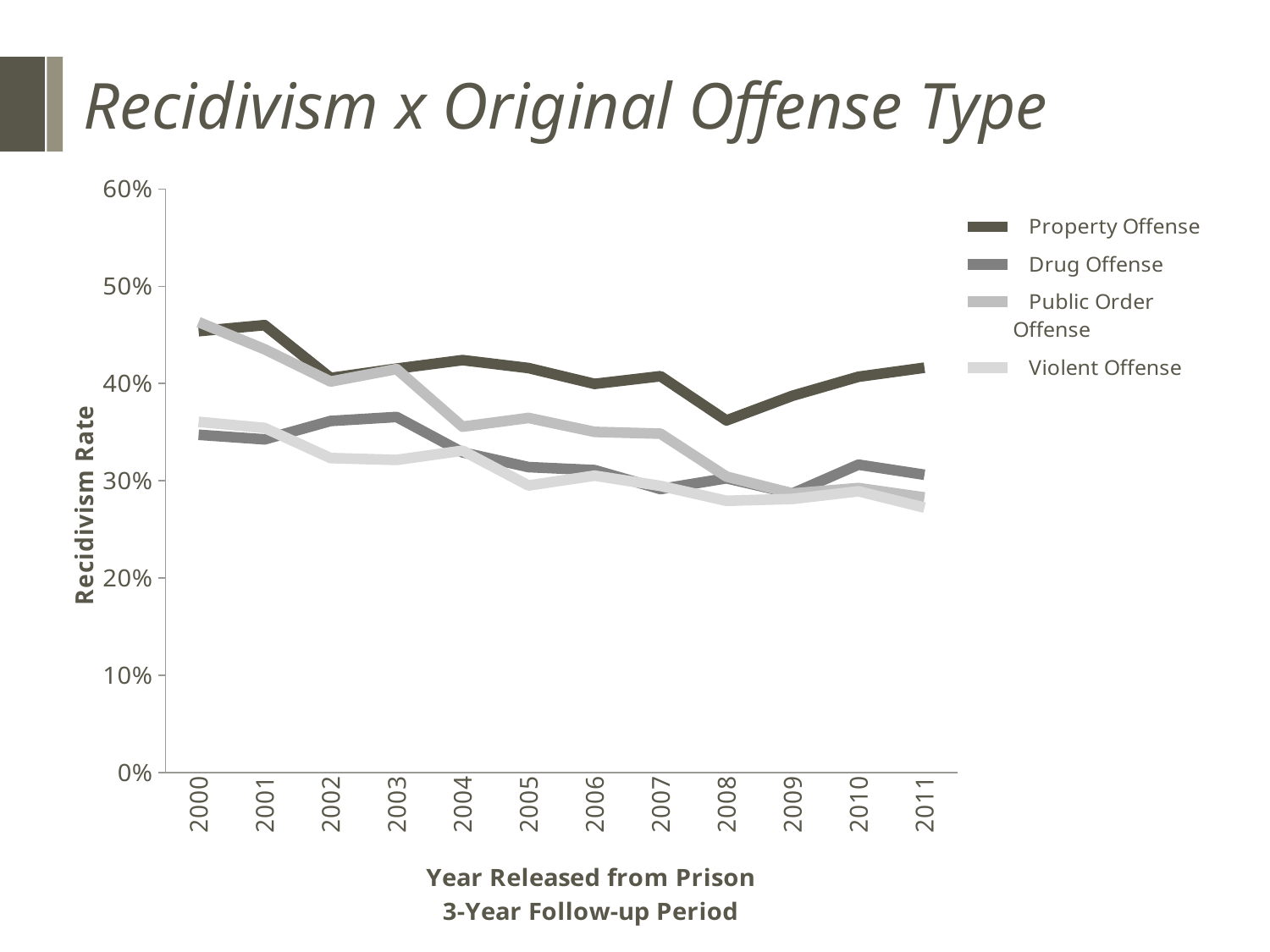
How many years are plotted along the x axis? 12 Which offense type has the lowest recidivism rate in 2002? Violent Offense What is the title of the x axis? Year Released from Prison 3-Year Follow-up Period Which offense type has the highest recidivism rate in 2008? Property Offense Is the recidivism rate for Violent Offense in 2011 greater or less than 30%? less What is the title of the y axis? Recidivism Rate What kind of chart is shown on the slide? Line chart How many series does the legend list? 4 Does the recidivism rate for Public Order Offense generally rise or fall from 2000 to 2011? Fall Is the recidivism rate for Public Order Offense in 2000 greater or less than 40%? greater Is the recidivism rate for Property Offense in 2008 greater or less than 40%? less